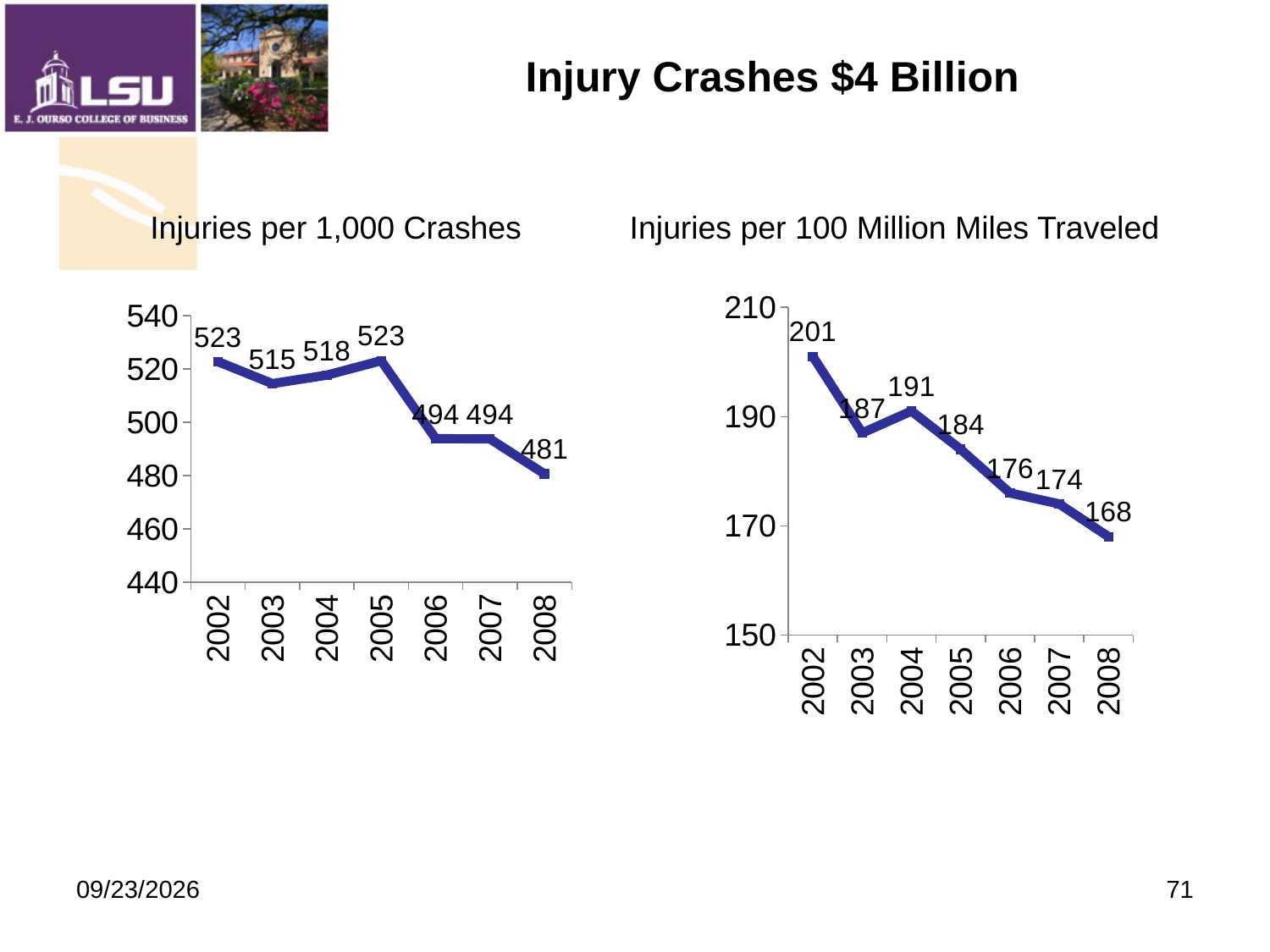
In the 'Injuries per 100 Million Miles Traveled' chart, what is the value for 2005? 184 In the 'Injuries per 100 Million Miles Traveled' chart, do the values generally rise or fall from 2002 to 2008? fall In the 'Injuries per 100 Million Miles Traveled' chart, is the value for 2006 greater or less than 170? greater In the 'Injuries per 1,000 Crashes' chart, what is the value for 2008? 481 In the 'Injuries per 1,000 Crashes' chart, which is larger, the value for 2003 or the value for 2004? 2004 In the 'Injuries per 100 Million Miles Traveled' chart, what is the value for 2002? 201 In the 'Injuries per 100 Million Miles Traveled' chart, what is the difference between the 2002 value and the 2008 value? 33 In the 'Injuries per 1,000 Crashes' chart, what is the difference between the 2005 value and the 2008 value? 42 How many years are plotted in the 'Injuries per 1,000 Crashes' chart? 7 What kind of chart is the 'Injuries per 100 Million Miles Traveled' chart? line chart In the 'Injuries per 1,000 Crashes' chart, which year has the lowest value? 2008 In the 'Injuries per 100 Million Miles Traveled' chart, which year has the highest value? 2002